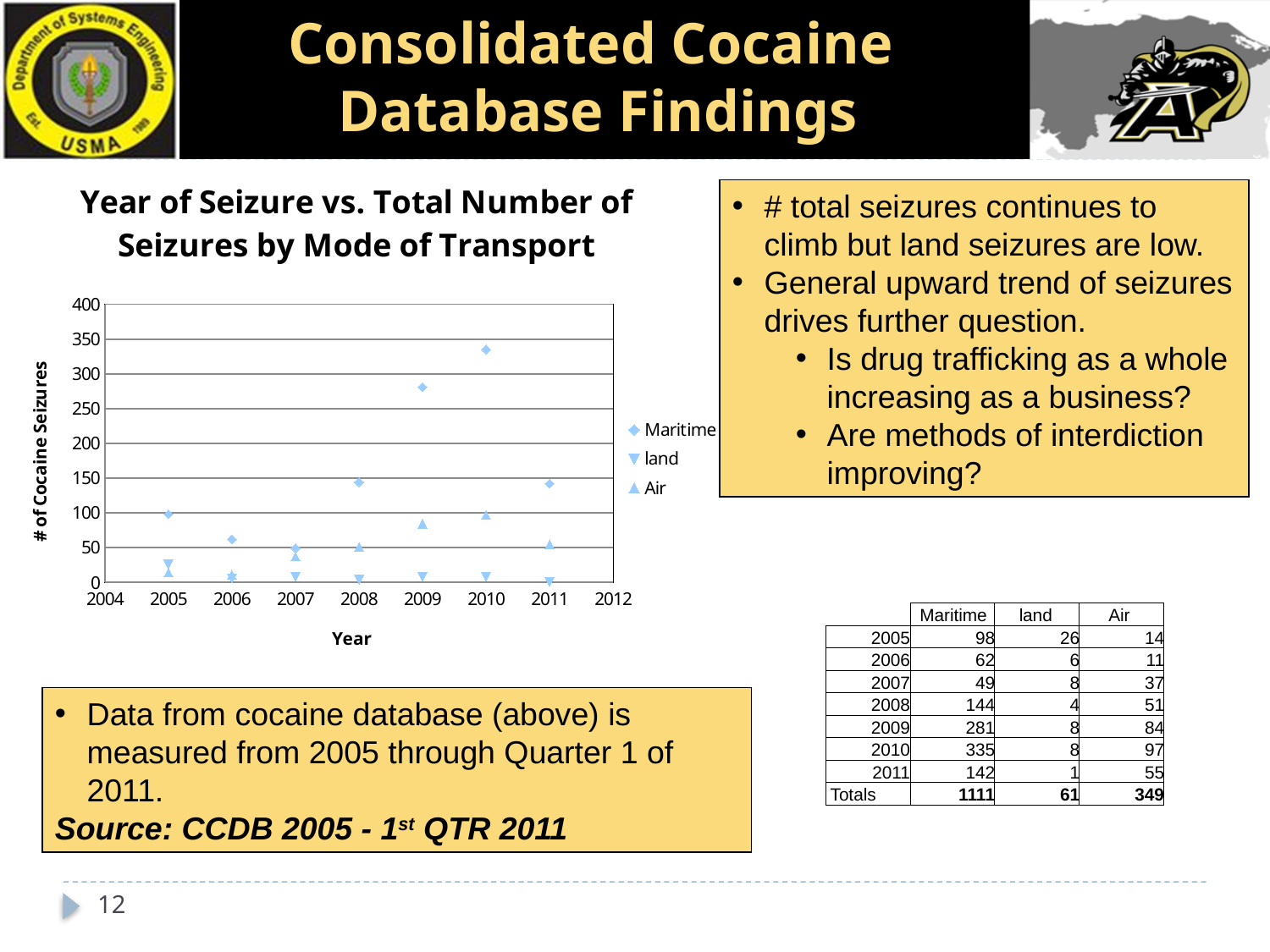
Do the Maritime values rise or fall from 2007 to 2010? rise In 2009, which is larger, the Maritime value or the Air value? Maritime According to the table on the slide, what is the difference between the Maritime values for 2010 and 2009? 54 What are the three series named in the chart legend? Maritime, land, Air Is the Air value for 2008 greater or less than 100? less In which year is the Maritime value highest? 2010 How many years have data points plotted in the chart? 7 In which year is the land value lowest? 2011 What kind of chart is shown on the slide? Scatter chart Is the Maritime value for 2010 greater or less than 300? greater According to the table on the slide, what is the Air value for 2009? 84 How many series does the chart legend list? 3